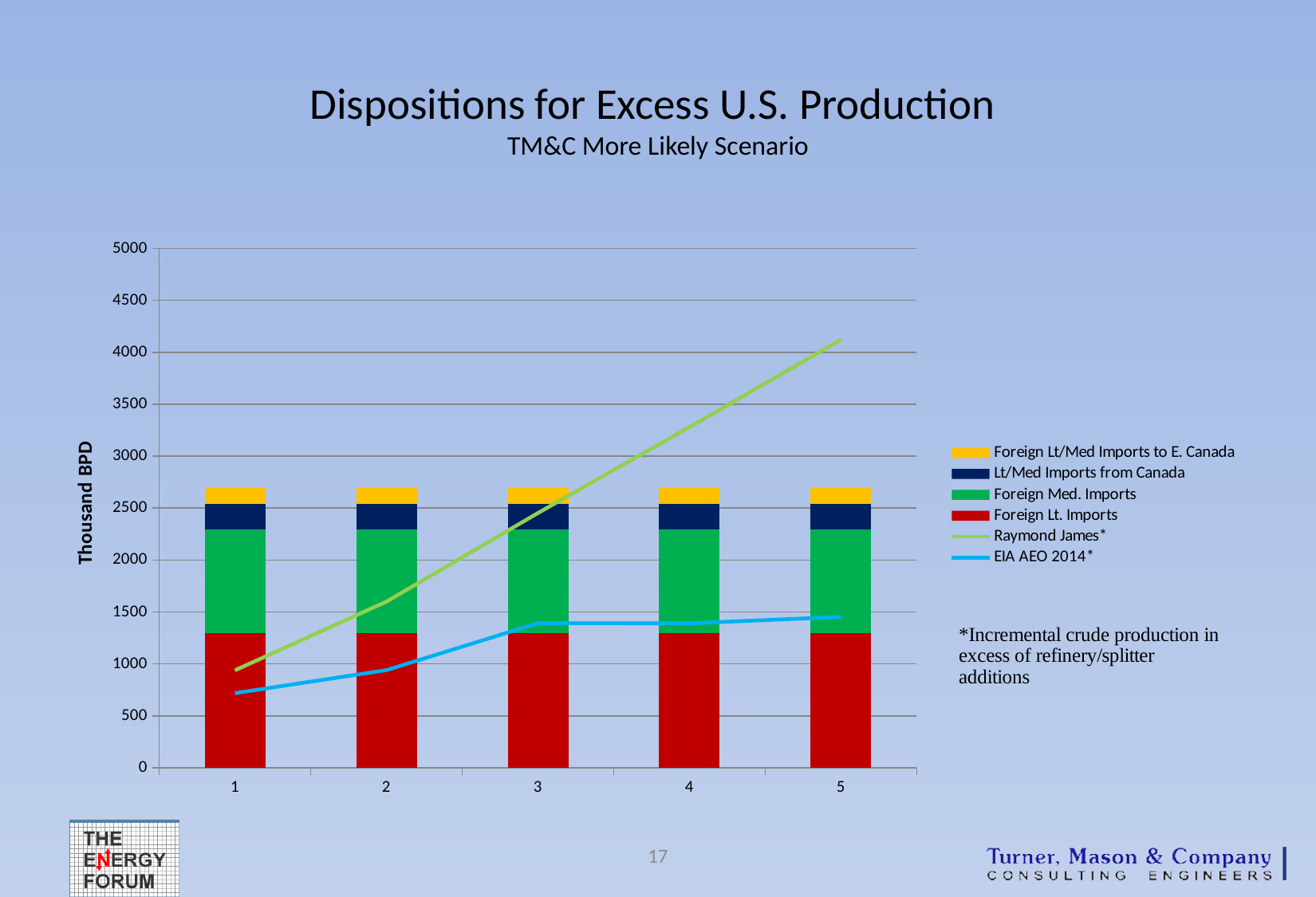
At category 5, which is larger: the Raymond James* value or the EIA AEO 2014* value? Raymond James* How many series does the legend list? 6 Is the EIA AEO 2014* value at category 1 greater or less than 1000? less How many categories are shown along the x axis? 5 Is the Raymond James* value at category 3 greater or less than 2000? greater Does the Raymond James* line rise or fall from category 1 to category 5? Rise What colour represents Foreign Lt. Imports in the legend? Red What is the label on the y axis? Thousand BPD What kind of chart is shown on the slide? A stacked bar chart with line series Is the Foreign Lt. Imports value at category 1 greater or less than 1000? greater